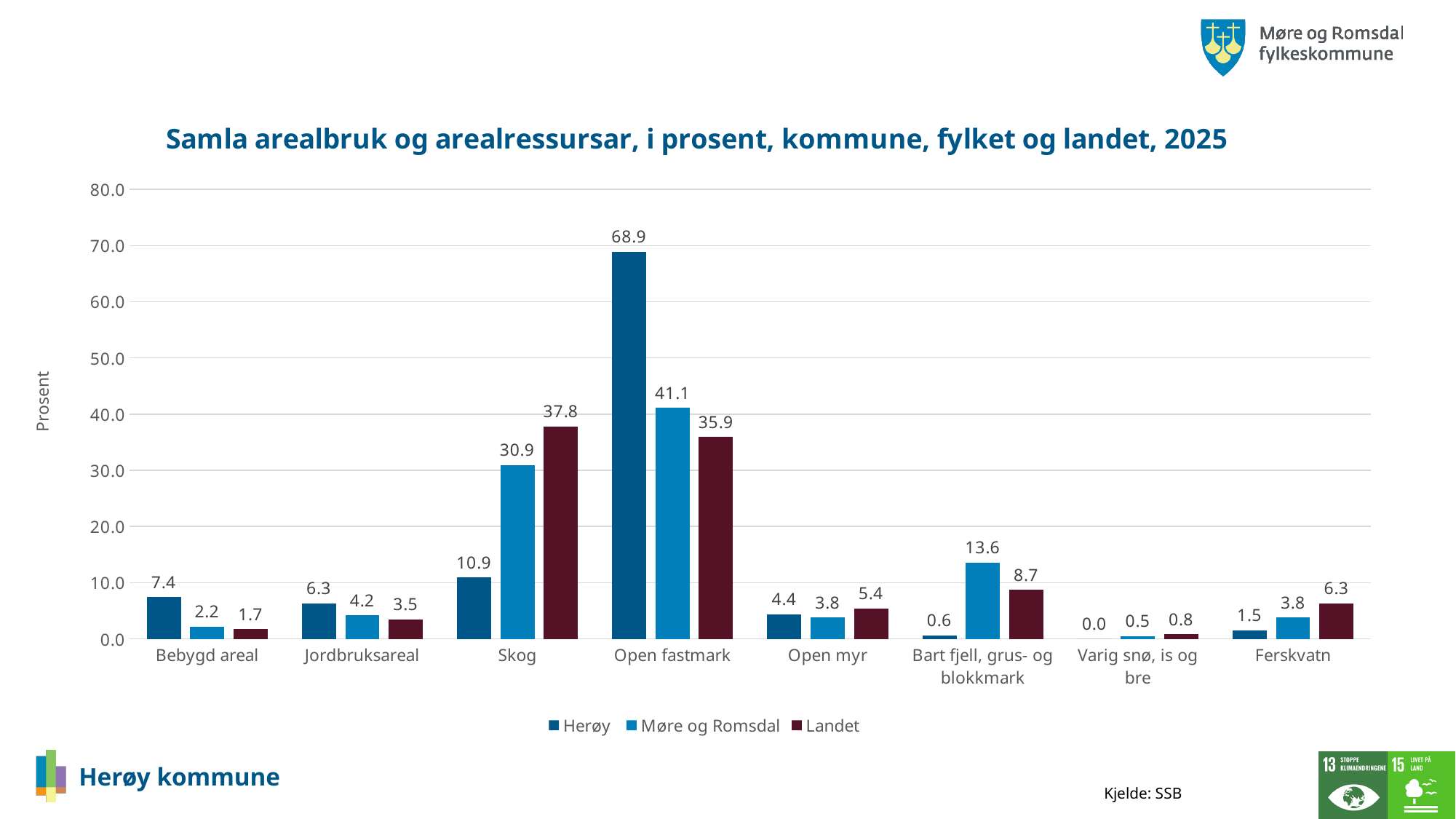
How many categories are shown on the x axis? 8 What kind of chart is shown on the slide? Bar chart What is the label on the y axis? Prosent What is the difference between the Herøy and Møre og Romsdal values for Open fastmark? 27.8 Which is larger in the Skog category: the value for Herøy or the value for Landet? Landet What is the value for Møre og Romsdal in the Bart fjell, grus- og blokkmark category? 13.6 What is the value for Landet in the Skog category? 37.8 Is the value for Møre og Romsdal in the Open fastmark category greater or less than 40.0? greater What is the value for Herøy in the Open fastmark category? 68.9 How many series does the legend list? 3 Which category has the highest value for Herøy? Open fastmark Which category has the lowest value for Møre og Romsdal? Varig snø, is og bre